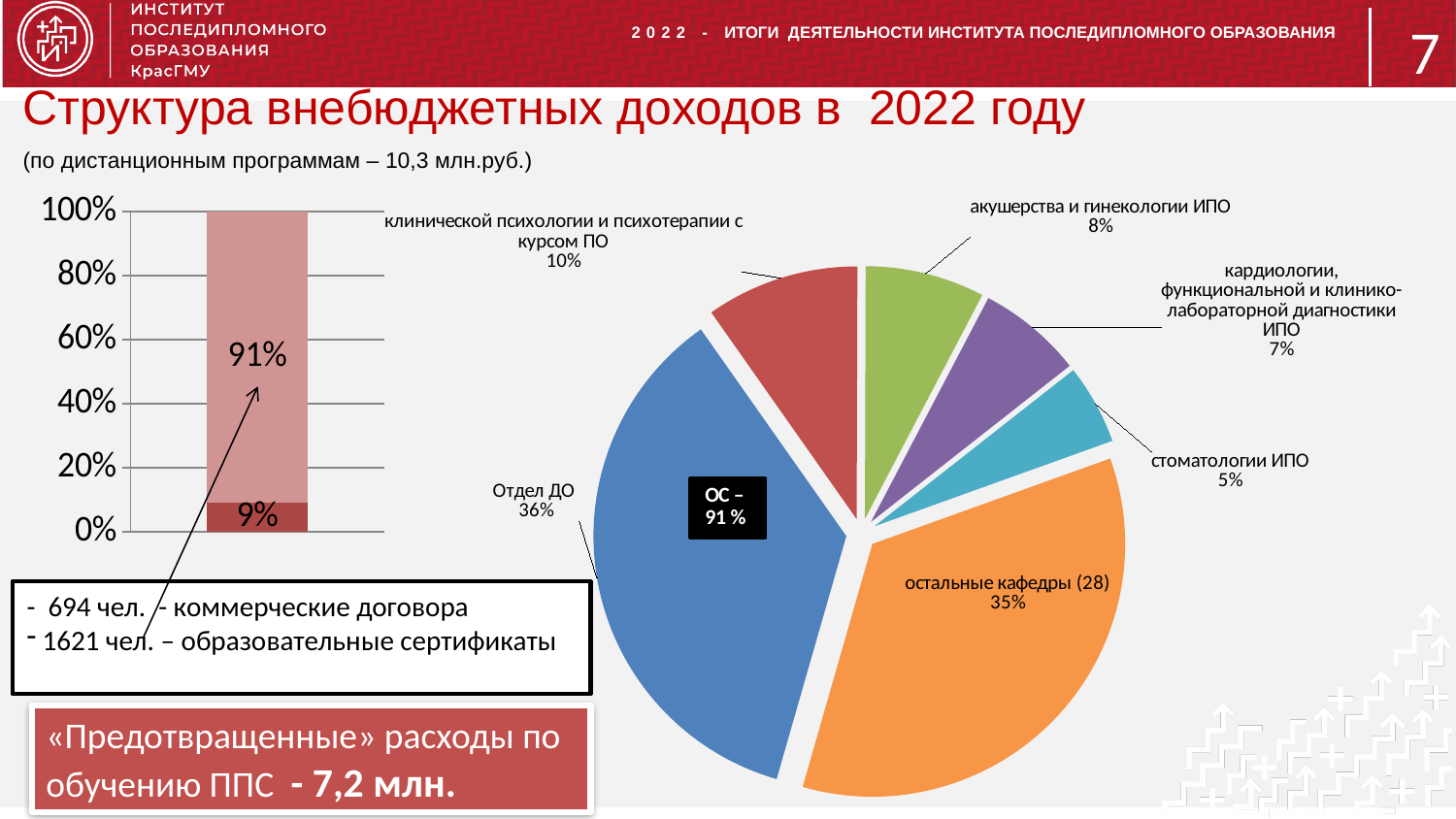
In the pie chart, what share does стоматологии ИПО have? 5% In the pie chart, how many slices are there? 6 In the pie chart, which is larger: клинической психологии и психотерапии с курсом ПО or кардиологии, функциональной и клинико-лабораторной диагностики ИПО? клинической психологии и психотерапии с курсом ПО In the pie chart, what share does остальные кафедры (28) have? 35% In the pie chart, which slice is the largest? Отдел ДО In the bar chart on the left, what value is shown for the larger (upper) segment? 91% In the pie chart, what share does Отдел ДО have? 36% In the pie chart, which slice is the smallest? стоматологии ИПО In the pie chart, what share does акушерства и гинекологии ИПО have? 8% In the pie chart, what is the difference between the shares of акушерства и гинекологии ИПО and стоматологии ИПО? 3% What kind of chart is the chart on the left of the slide? bar chart In the bar chart on the left, what value is shown for the smaller (lower) segment? 9%